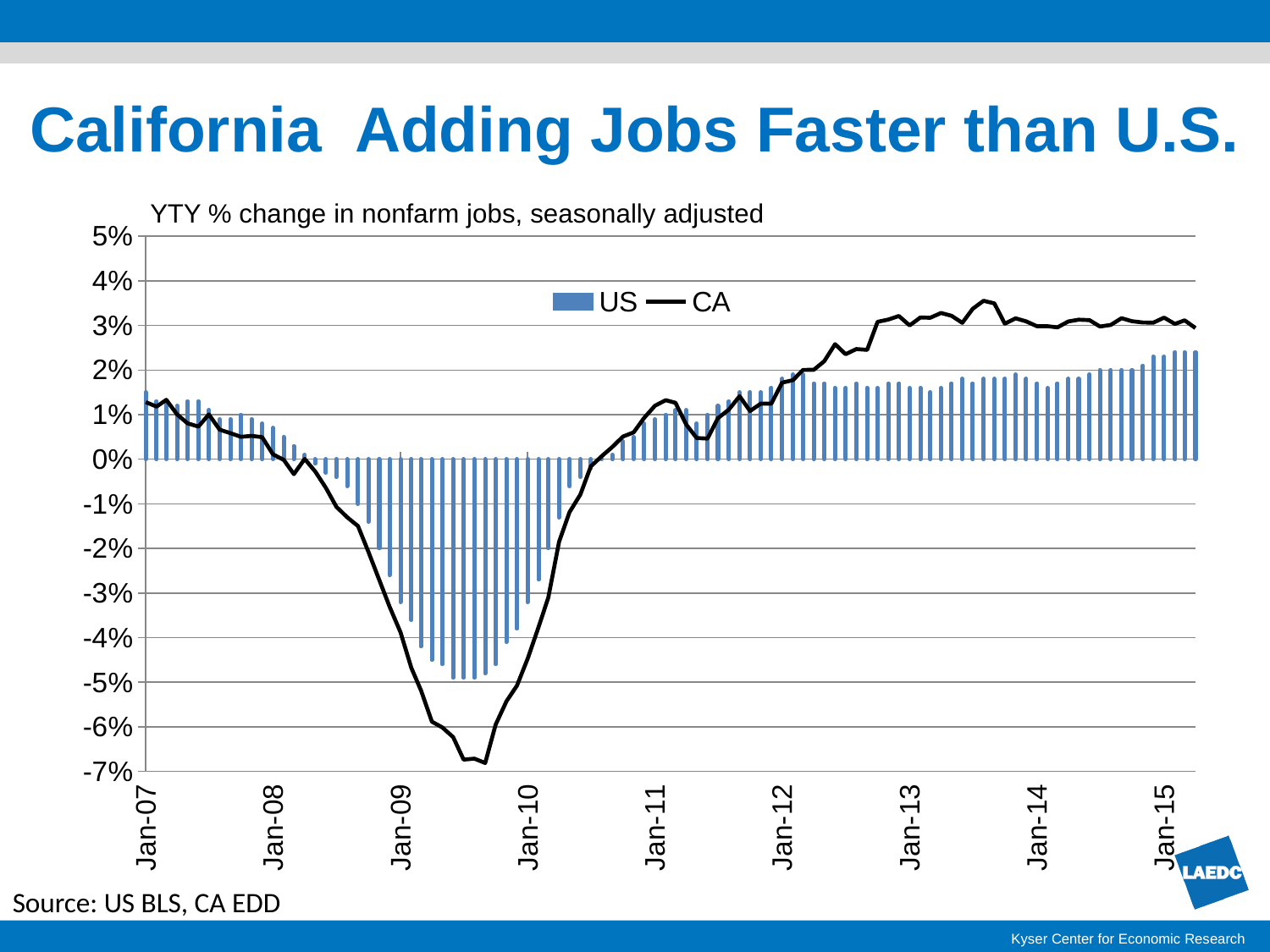
What kind of chart is used for the US series? Bar chart Is the US value at Jan-15 greater or less than 2%? greater Is the US value at Jan-07 greater or less than 1%? greater Is the lowest value of the CA line greater or less than -6%? less Which series reaches the lowest value on the chart, US or CA? CA What is the subtitle describing the measure plotted in the chart? YTY % change in nonfarm jobs, seasonally adjusted Which series is shown as a black line in the chart? CA At Jan-15, which series has the higher value, US or CA? CA Does the CA line rise or fall between Jan-10 and Jan-12? Rise How many series does the chart legend list? 2